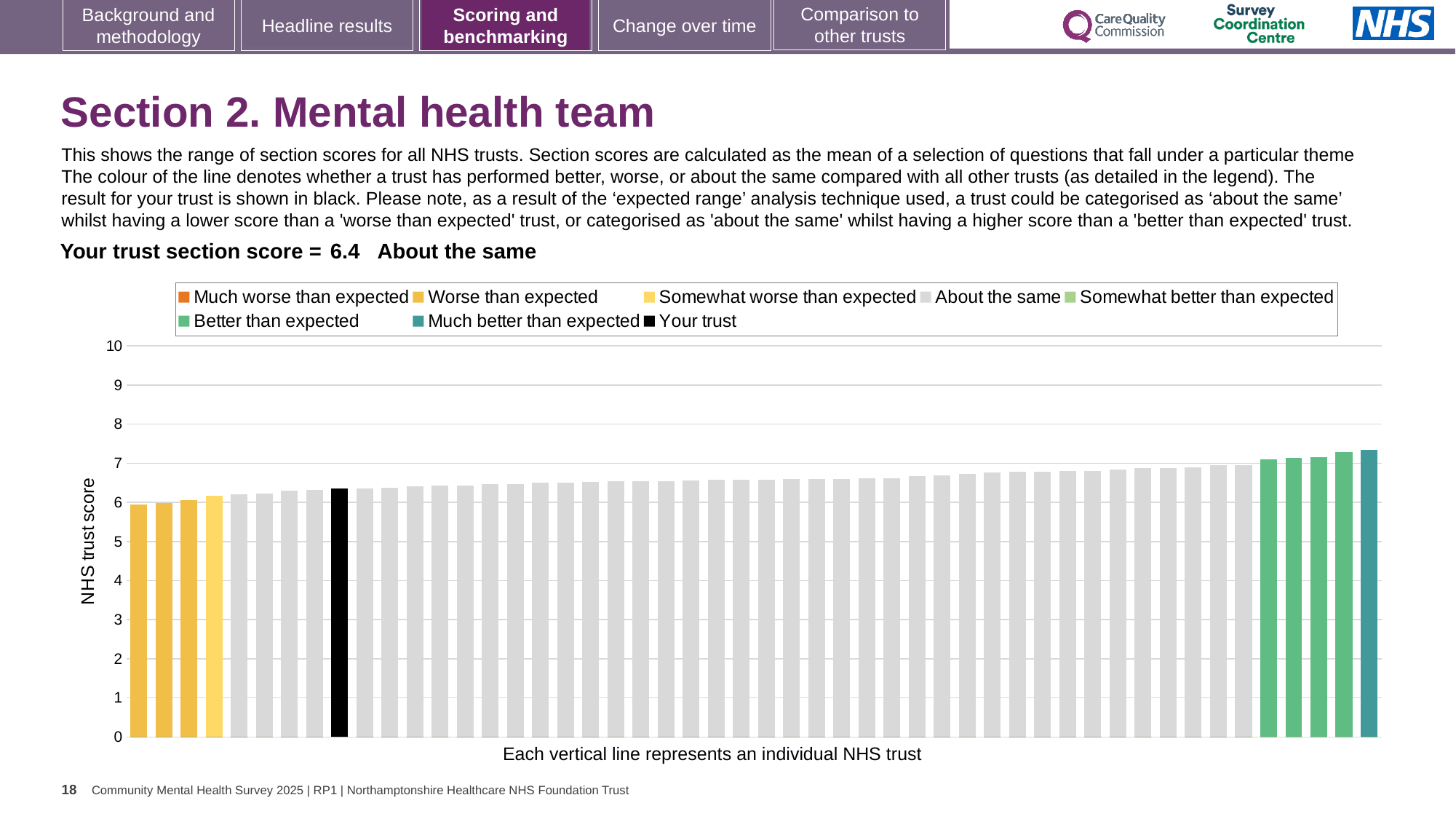
Do the bar values rise or fall from left to right along the x axis? rise What kind of chart is shown on the slide? bar chart What colour is the bar representing your trust? black Is the value of the lowest bar greater or less than 7? less Is the value of the highest bar greater or less than 7? greater Is the value for your trust (the black bar) greater or less than 6? greater What is the section score for your trust shown on the slide? 6.4 How many entries does the chart legend list? 8 Which category is your trust placed in according to the text above the chart? About the same What is the label on the y axis of the chart? NHS trust score